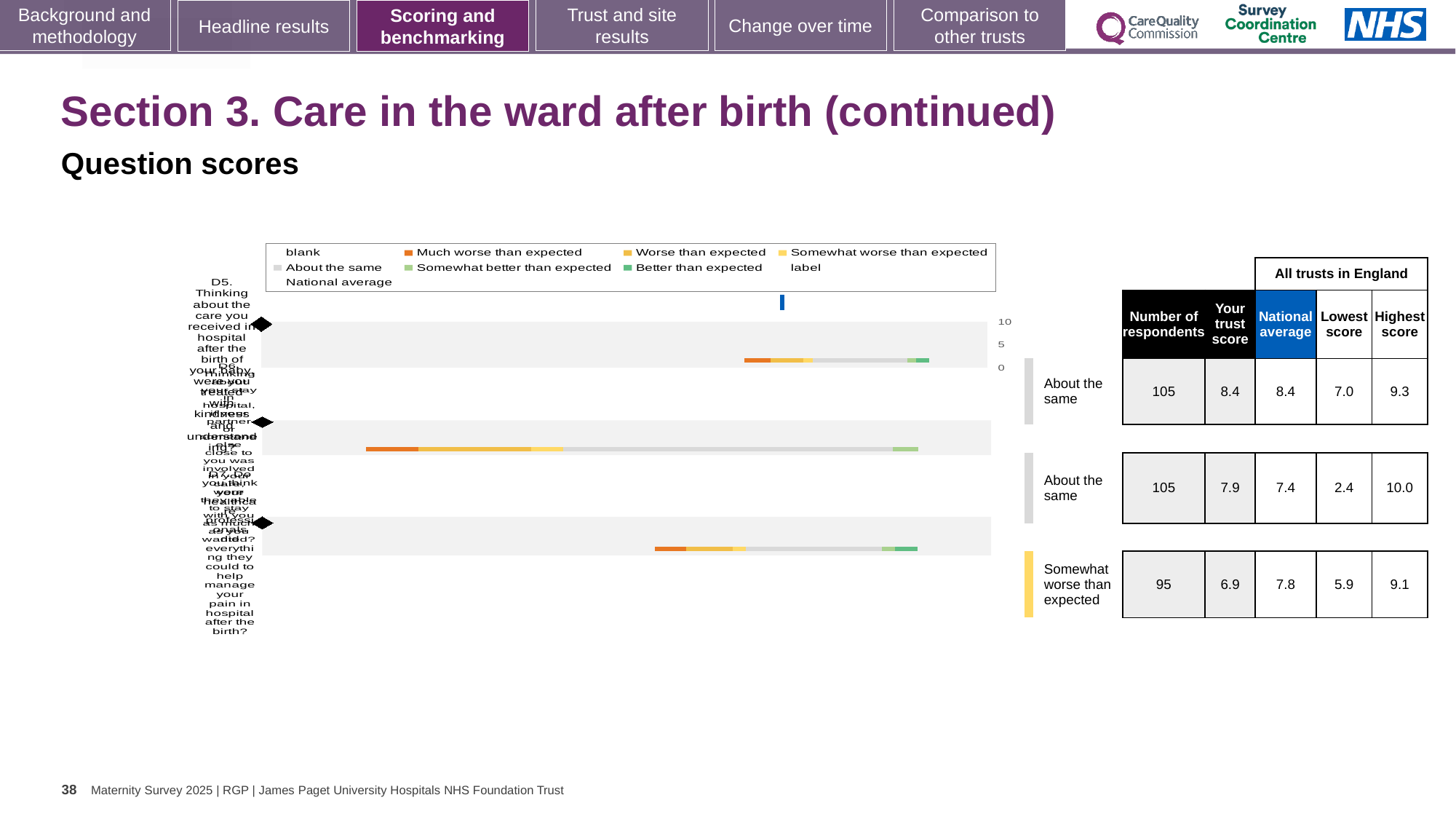
In the table next to the chart, what is the lowest score for the second question row? 2.4 What kind of chart is shown on the slide? bar chart In the table next to the chart, what is the national average for the third question row? 7.8 In the table next to the chart, what is the difference between the trust score and the national average for the second question row? 0.5 What benchmark category is shown for the third question row? Somewhat worse than expected What colour does the legend use for 'Much worse than expected'? orange How many entries does the chart legend list? 9 In the table next to the chart, which question row has the highest 'Highest score' value? the second row (10.0) What is the highest tick value shown on the chart's axis? 10 In the table next to the chart, what is the number of respondents for the first question row? 105 In the table next to the chart, what is the trust score for the third question row? 6.9 How many question rows (bars) are plotted in the chart? 3